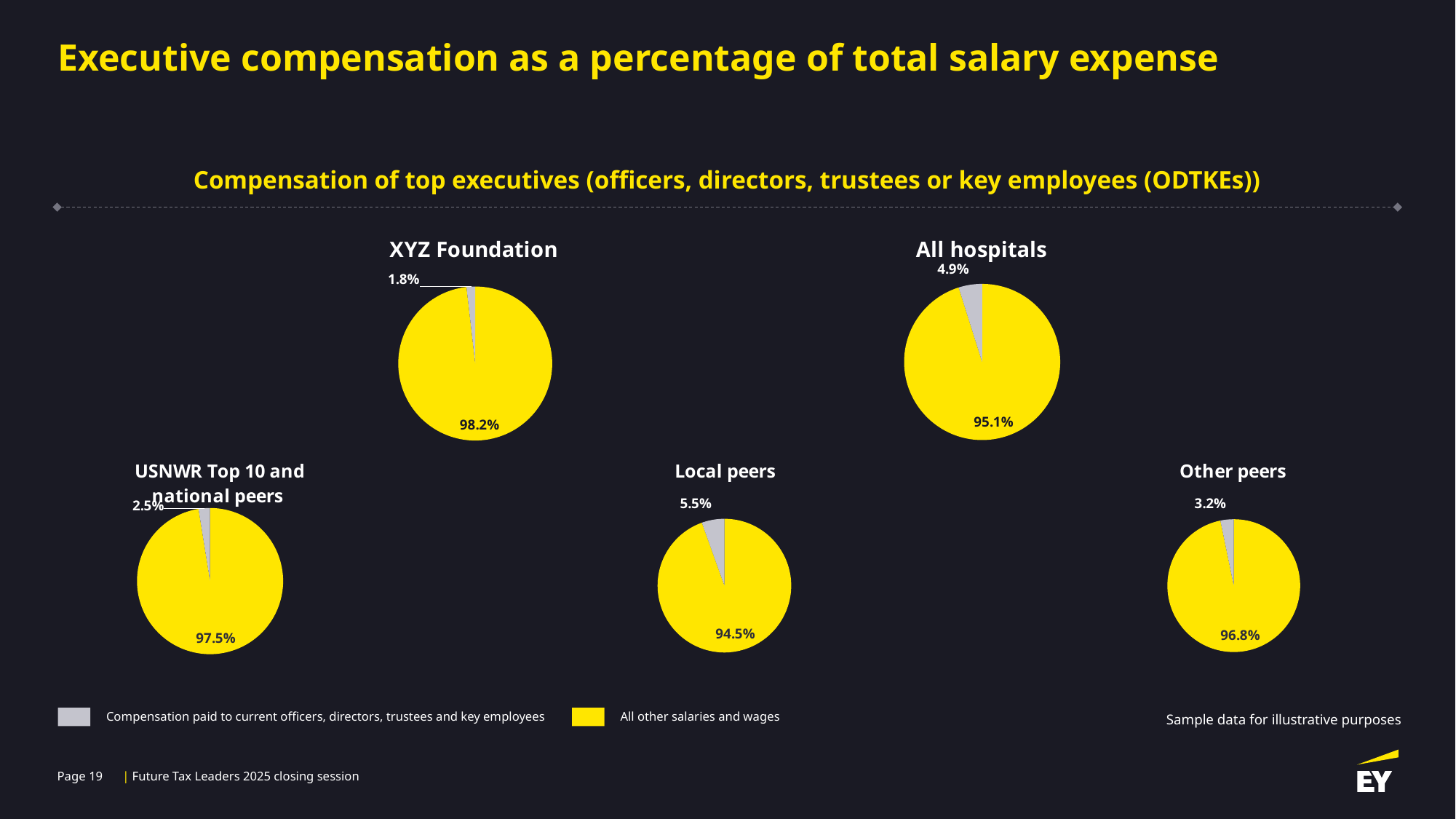
In the Other peers pie chart, what percentage is all other salaries and wages? 96.8% In the USNWR Top 10 and national peers pie chart, what percentage is compensation paid to current officers, directors, trustees and key employees? 2.5% Across the five pie charts, which group has the lowest percentage of compensation paid to current officers, directors, trustees and key employees? XYZ Foundation In the All hospitals pie chart, what percentage is all other salaries and wages? 95.1% Which colour represents all other salaries and wages in the pie charts? Yellow In the Local peers pie chart, what share is compensation paid to current officers, directors, trustees and key employees? 5.5% In the XYZ Foundation pie chart, what percentage is compensation paid to current officers, directors, trustees and key employees? 1.8% What type of chart is used to show the compensation breakdown for each group? Pie chart What is the difference between the executive compensation share for Local peers and for XYZ Foundation? 3.7% How many pie charts are shown on the slide? 5 Which has a larger executive compensation share: All hospitals or Other peers? All hospitals Across the five pie charts, which group has the highest percentage of compensation paid to current officers, directors, trustees and key employees? Local peers